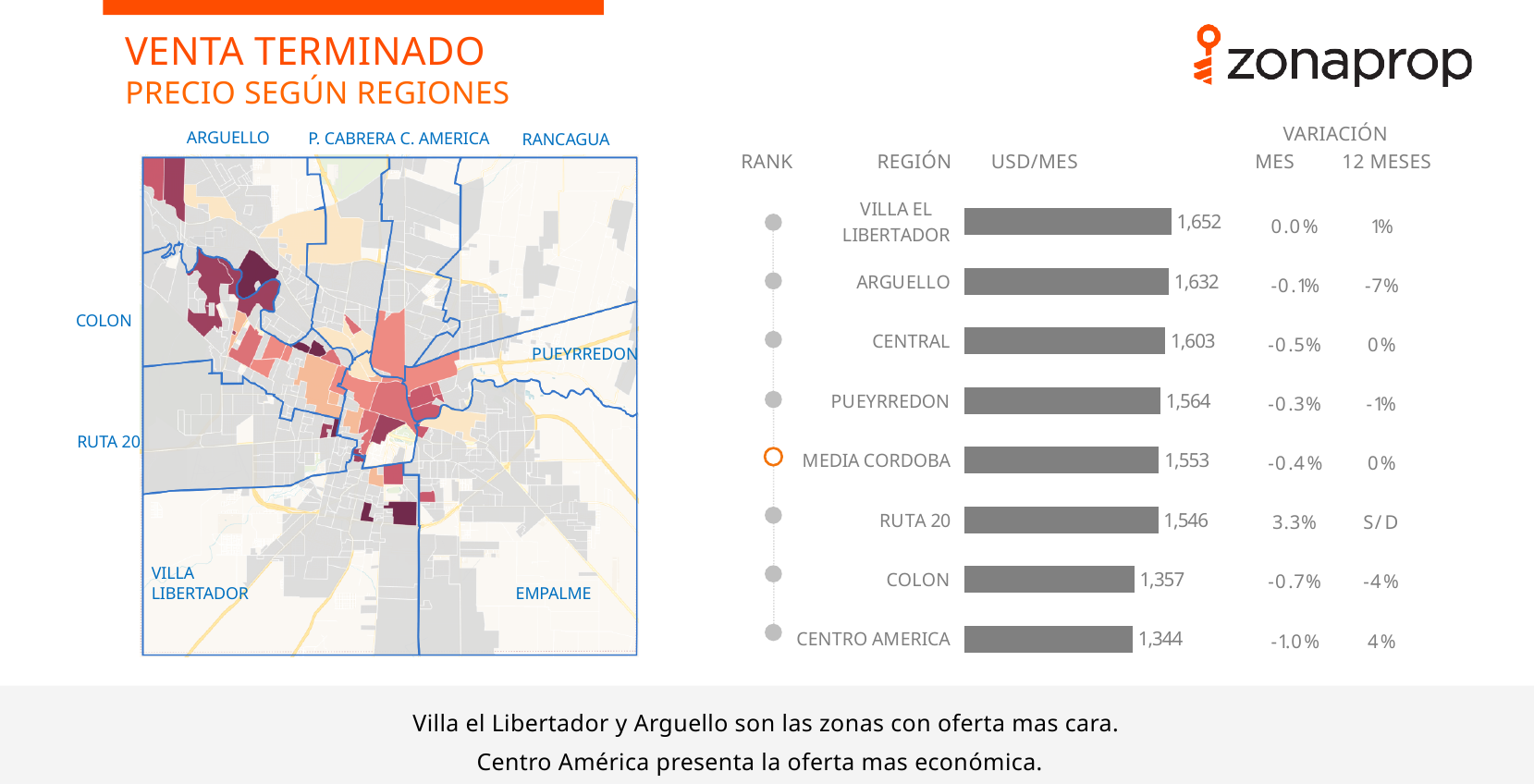
What is the USD/MES value for RUTA 20 in the bar chart? 1,546 Which region has the highest USD/MES value in the bar chart? VILLA EL LIBERTADOR What is the 12-month variation (VARIACIÓN 12 MESES) shown for ARGUELLO? -7% What kind of chart is used to show USD/MES by region? Bar chart Which has a higher USD/MES value, PUEYRREDON or COLON? PUEYRREDON Do the USD/MES values increase or decrease going down the bar chart from VILLA EL LIBERTADOR to CENTRO AMERICA? Decrease What is the USD/MES value for VILLA EL LIBERTADOR in the bar chart? 1,652 What is the difference in USD/MES between ARGUELLO and CENTRAL? 29 How many regions are shown in the bar chart? 8 Which region has the lowest USD/MES value in the bar chart? CENTRO AMERICA What is the USD/MES value for COLON in the bar chart? 1,357 What is the difference in USD/MES between VILLA EL LIBERTADOR and CENTRO AMERICA? 308